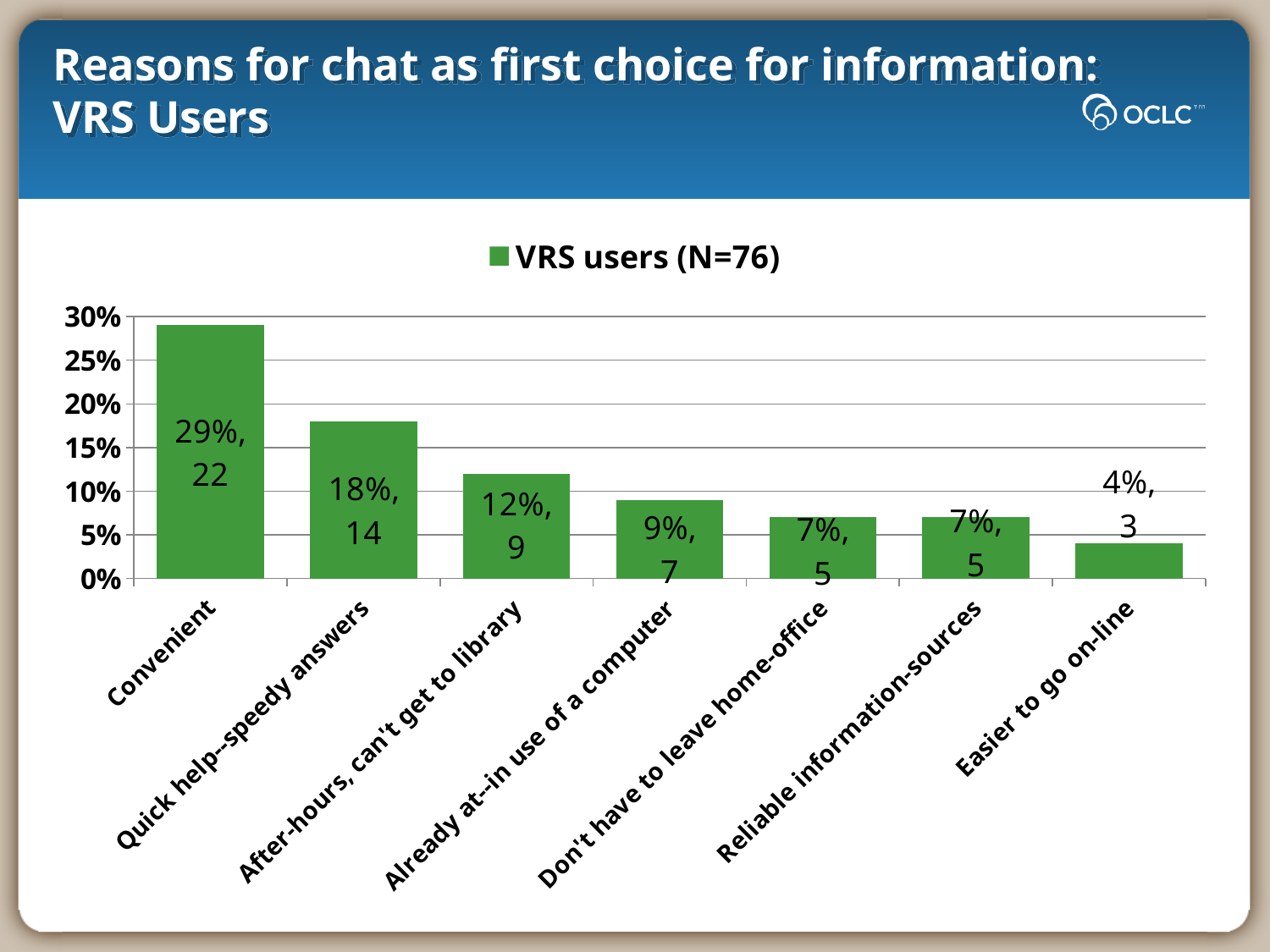
How many VRS users gave "Quick help--speedy answers" as their reason? 14 What is the legend entry for the series shown? VRS users (N=76) Do the values rise or fall from left to right along the x axis? Fall Which is larger: the value for "Already at--in use of a computer" or for "Easier to go on-line"? Already at--in use of a computer What is the difference in percentage points between "Convenient" and "Quick help--speedy answers"? 11% How many reasons (categories) are shown on the chart? 7 Which reason has the highest percentage? Convenient Which reason has the lowest percentage? Easier to go on-line What percentage of VRS users gave "Convenient" as their reason? 29% What kind of chart is shown? Bar chart What percentage is shown for "After-hours, can't get to library"? 12% How many series does the legend list? 1